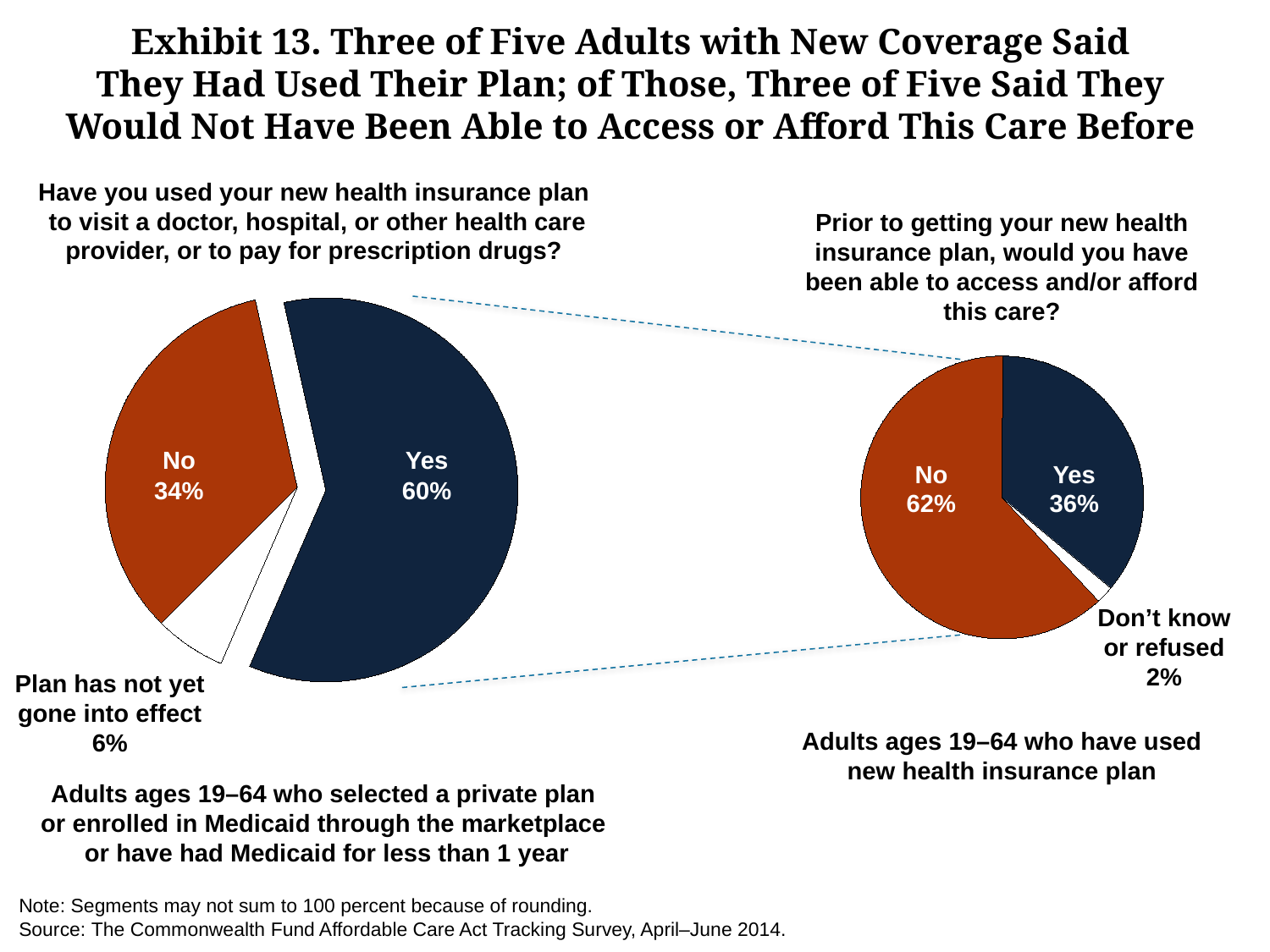
In the left pie chart (Have you used your new health insurance plan...), how many percentage points larger is the Yes share than the No share? 26 percentage points In the right pie chart (Prior to getting your new health insurance plan...), what share answered No? 62% In the right pie chart (Prior to getting your new health insurance plan...), what share answered Don't know or refused? 2% In the left pie chart (Have you used your new health insurance plan...), what share of adults answered No? 34% In the left pie chart (Have you used your new health insurance plan...), what share of adults answered Yes? 60% In the right pie chart (Prior to getting your new health insurance plan...), what share answered Yes? 36% What type of chart is used on this slide? Pie chart In the right pie chart (Prior to getting your new health insurance plan...), which is larger, the Yes share or the No share? No How many segments does the right pie chart (Prior to getting your new health insurance plan...) have? 3 In the right pie chart (Prior to getting your new health insurance plan...), which response has the smallest share? Don't know or refused In the left pie chart (Have you used your new health insurance plan...), which response has the largest share? Yes In the left pie chart (Have you used your new health insurance plan...), what share said their plan has not yet gone into effect? 6%